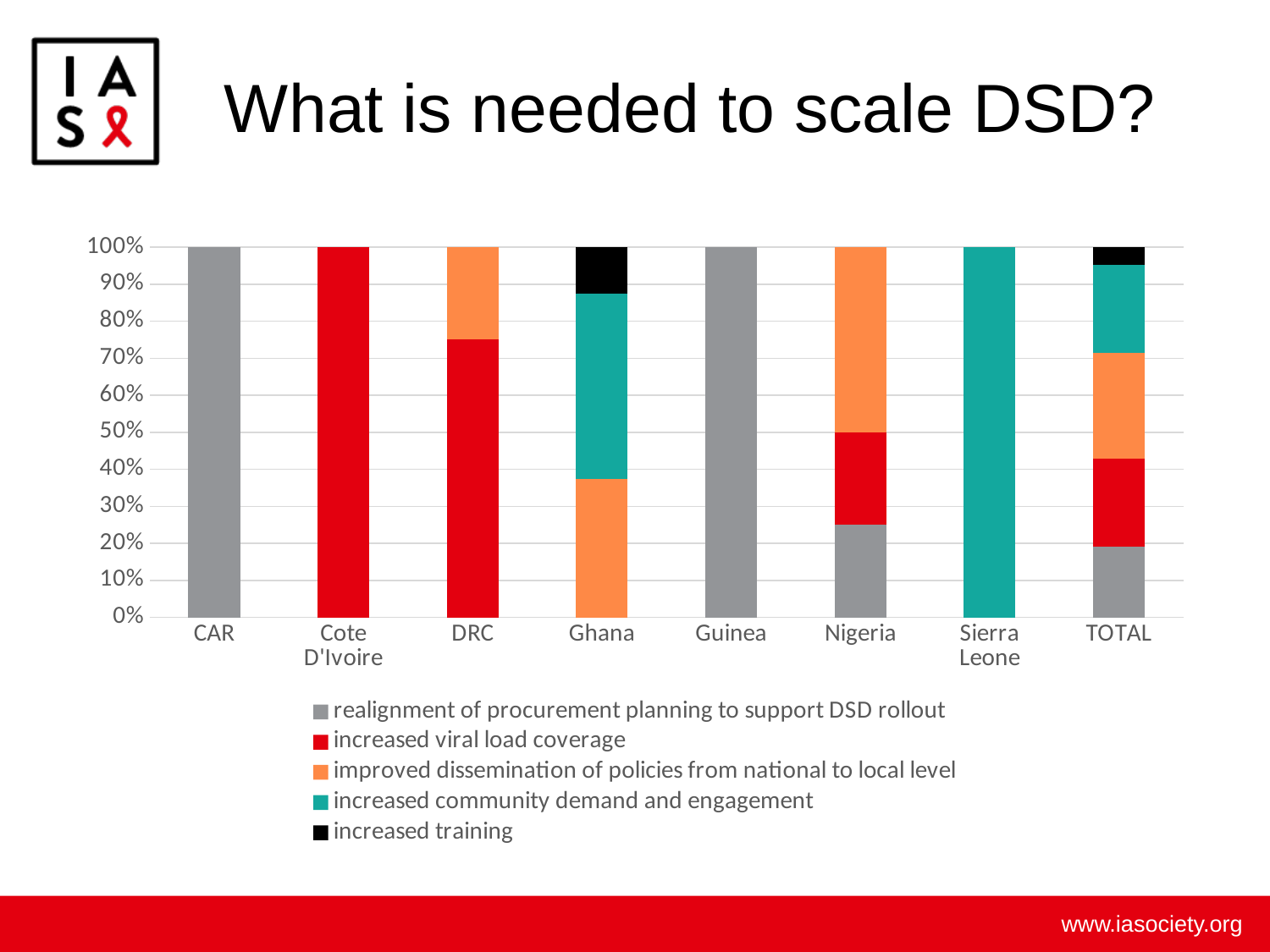
Is the 'increased community demand and engagement' share for Ghana greater or less than 40%? greater What kind of chart is shown on the slide? stacked bar chart What share of the Cote D'Ivoire bar is 'increased viral load coverage'? 100% In the Nigeria bar, which is larger: 'improved dissemination of policies from national to local level' or 'increased viral load coverage'? improved dissemination of policies from national to local level What share of the CAR bar is 'realignment of procurement planning to support DSD rollout'? 100% Is the 'realignment of procurement planning to support DSD rollout' share for Nigeria greater or less than 30%? less Which colour represents 'increased training' in the legend? black Is the 'increased training' share in the TOTAL bar greater or less than 10%? less How many categories are shown along the x axis? 8 What share of the Sierra Leone bar is 'increased community demand and engagement'? 100% How many series does the legend list? 5